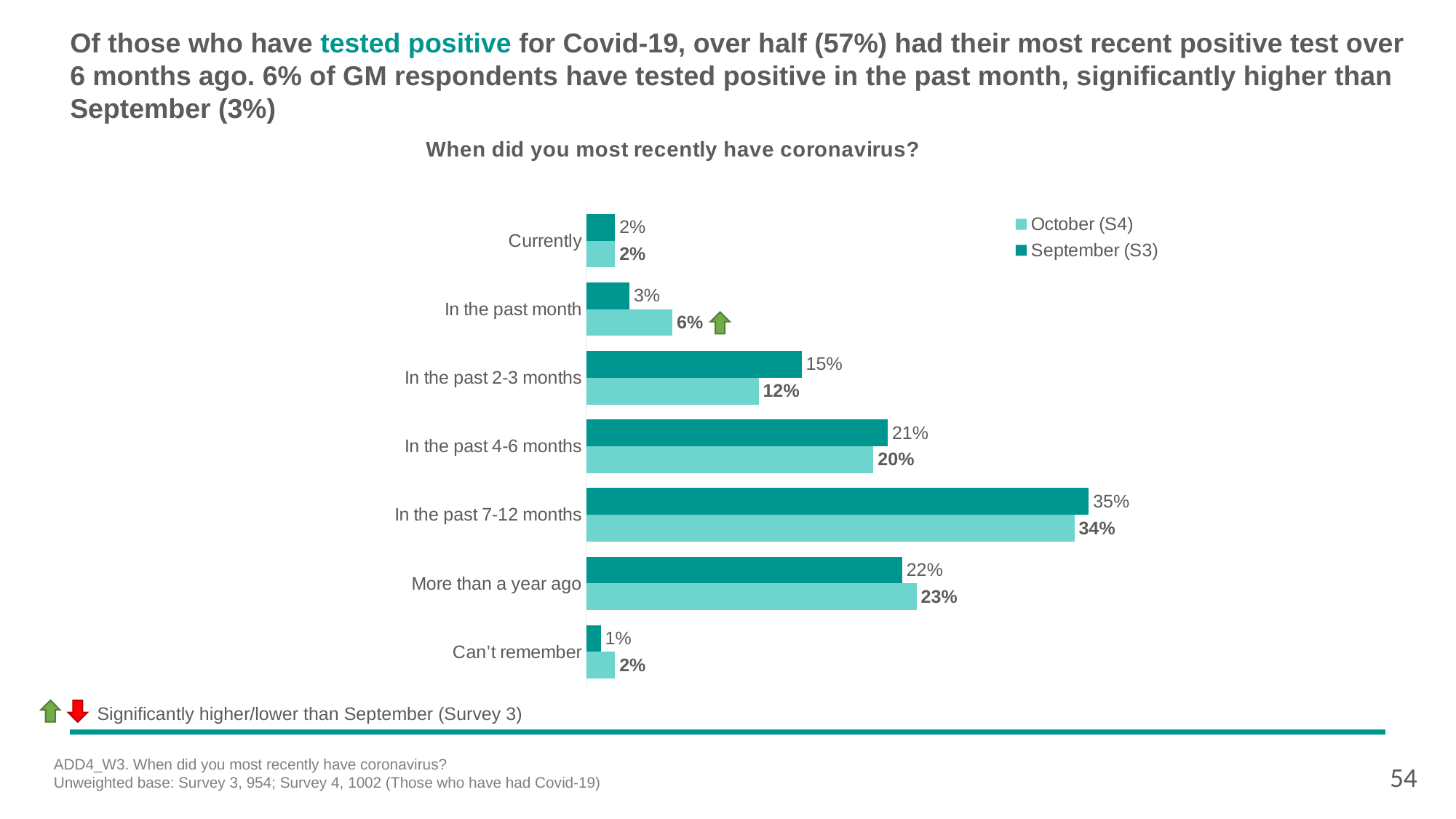
What is the October (S4) value for 'In the past month'? 6% What is the difference between the September (S3) and October (S4) values for 'In the past 2-3 months'? 3% What is the title of the chart? When did you most recently have coronavirus? What is the September (S3) value for 'In the past 7-12 months'? 35% What kind of chart is shown on the slide? Bar chart How many series does the legend list? 2 How many categories are shown on the chart? 7 Which category has the lowest September (S3) value? Can't remember Which category is marked with a green arrow indicating a significantly higher value than September? In the past month For 'In the past 4-6 months', which series has the larger value, September (S3) or October (S4)? September (S3) Which category has the highest October (S4) value? In the past 7-12 months What is the October (S4) value for 'More than a year ago'? 23%